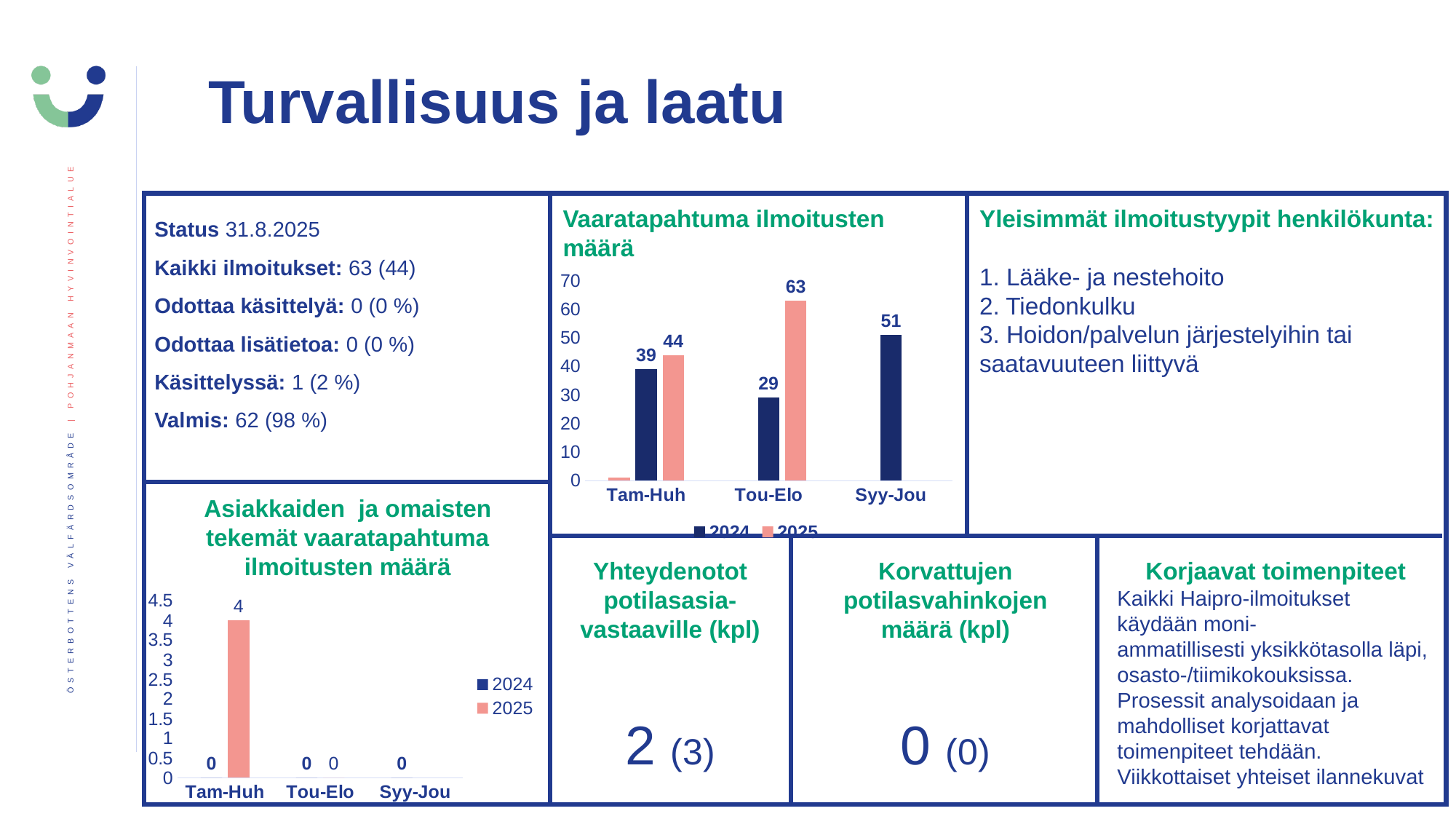
In the chart 'Vaaratapahtuma ilmoitusten määrä', how many series does the legend list? 2 In the chart 'Vaaratapahtuma ilmoitusten määrä', what is the 2025 value for Tou-Elo? 63 In the chart 'Vaaratapahtuma ilmoitusten määrä', which colour represents the 2025 series? pink In the chart 'Vaaratapahtuma ilmoitusten määrä', what is the difference between the 2025 and 2024 values for Tou-Elo? 34 In the chart 'Vaaratapahtuma ilmoitusten määrä', which is larger for Tam-Huh, the 2024 value or the 2025 value? 2025 In the chart 'Vaaratapahtuma ilmoitusten määrä', what is the 2024 value for Syy-Jou? 51 In the chart 'Asiakkaiden ja omaisten tekemät vaaratapahtuma ilmoitusten määrä', what is the 2024 value for Tou-Elo? 0 How many periods are shown on the x axis of the chart 'Asiakkaiden ja omaisten tekemät vaaratapahtuma ilmoitusten määrä'? 3 In the chart 'Vaaratapahtuma ilmoitusten määrä', what is the 2024 value for Tam-Huh? 39 In the chart 'Asiakkaiden ja omaisten tekemät vaaratapahtuma ilmoitusten määrä', what is the 2025 value for Tam-Huh? 4 In the chart 'Vaaratapahtuma ilmoitusten määrä', which period has the lowest 2024 value? Tou-Elo What kind of chart is 'Vaaratapahtuma ilmoitusten määrä'? bar chart